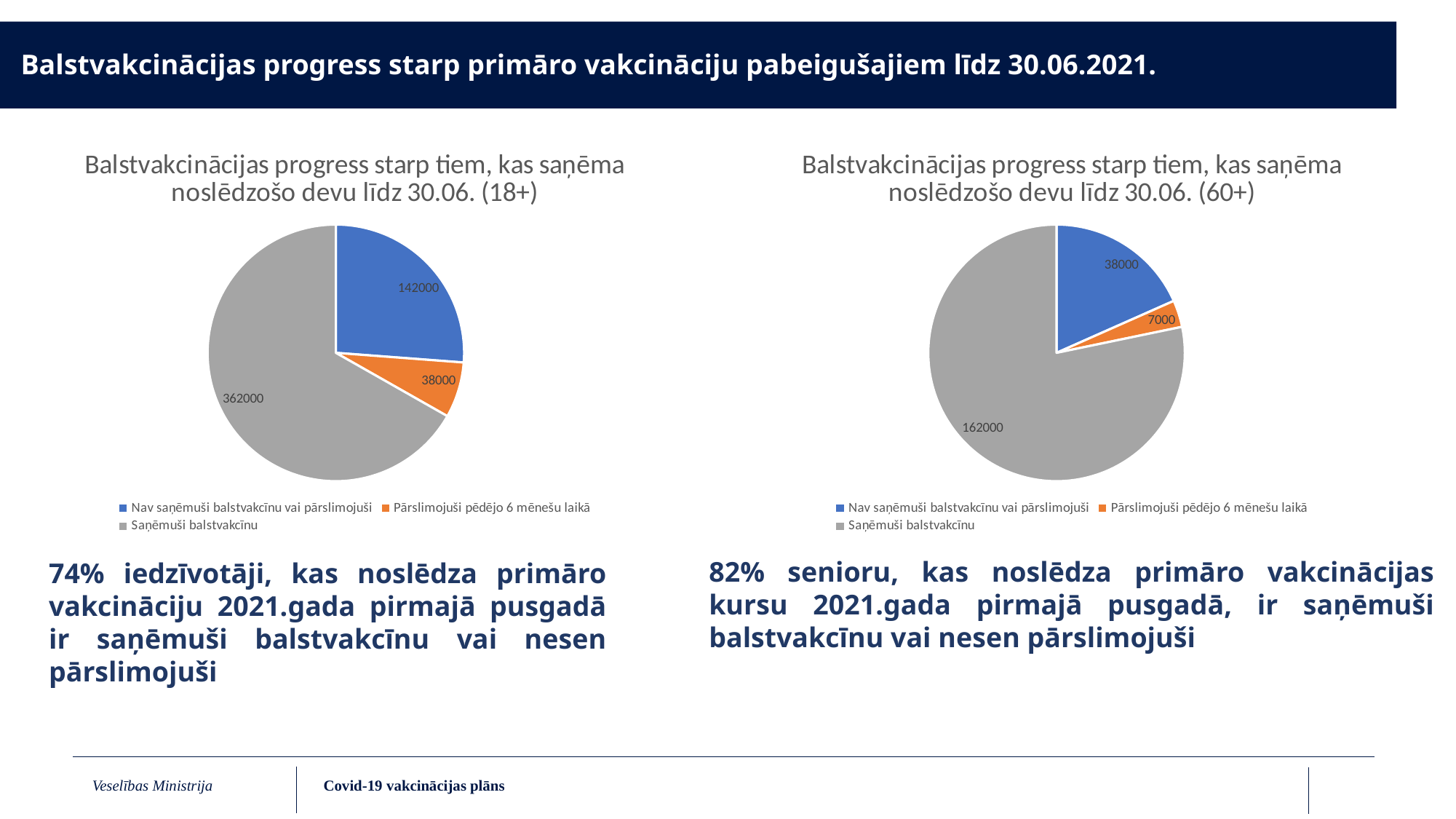
In the left pie chart (18+), what is the difference between 'Saņēmuši balstvakcīnu' and 'Nav saņēmuši balstvakcīnu vai pārslimojuši'? 220000 Which is larger: 'Nav saņēmuši balstvakcīnu vai pārslimojuši' in the left chart (18+) or 'Saņēmuši balstvakcīnu' in the right chart (60+)? Saņēmuši balstvakcīnu in the right chart (60+) In the right pie chart (60+), what is the difference between 'Nav saņēmuši balstvakcīnu vai pārslimojuši' and 'Pārslimojuši pēdējo 6 mēnešu laikā'? 31000 What is the total of all slices in the right pie chart (60+)? 207000 In the right pie chart (60+), what is the value for 'Pārslimojuši pēdējo 6 mēnešu laikā'? 7000 In the right pie chart (60+), what is the value for 'Saņēmuši balstvakcīnu'? 162000 How many categories does the left pie chart (18+) show? 3 In the right pie chart (60+), which category has the smallest slice? Pārslimojuši pēdējo 6 mēnešu laikā In the left pie chart (18+), what is the value for 'Saņēmuši balstvakcīnu'? 362000 What type of chart is used on the right side of the slide (60+)? Pie chart In the left pie chart (18+), what is the value for 'Nav saņēmuši balstvakcīnu vai pārslimojuši'? 142000 In the left pie chart (18+), which category has the largest slice? Saņēmuši balstvakcīnu